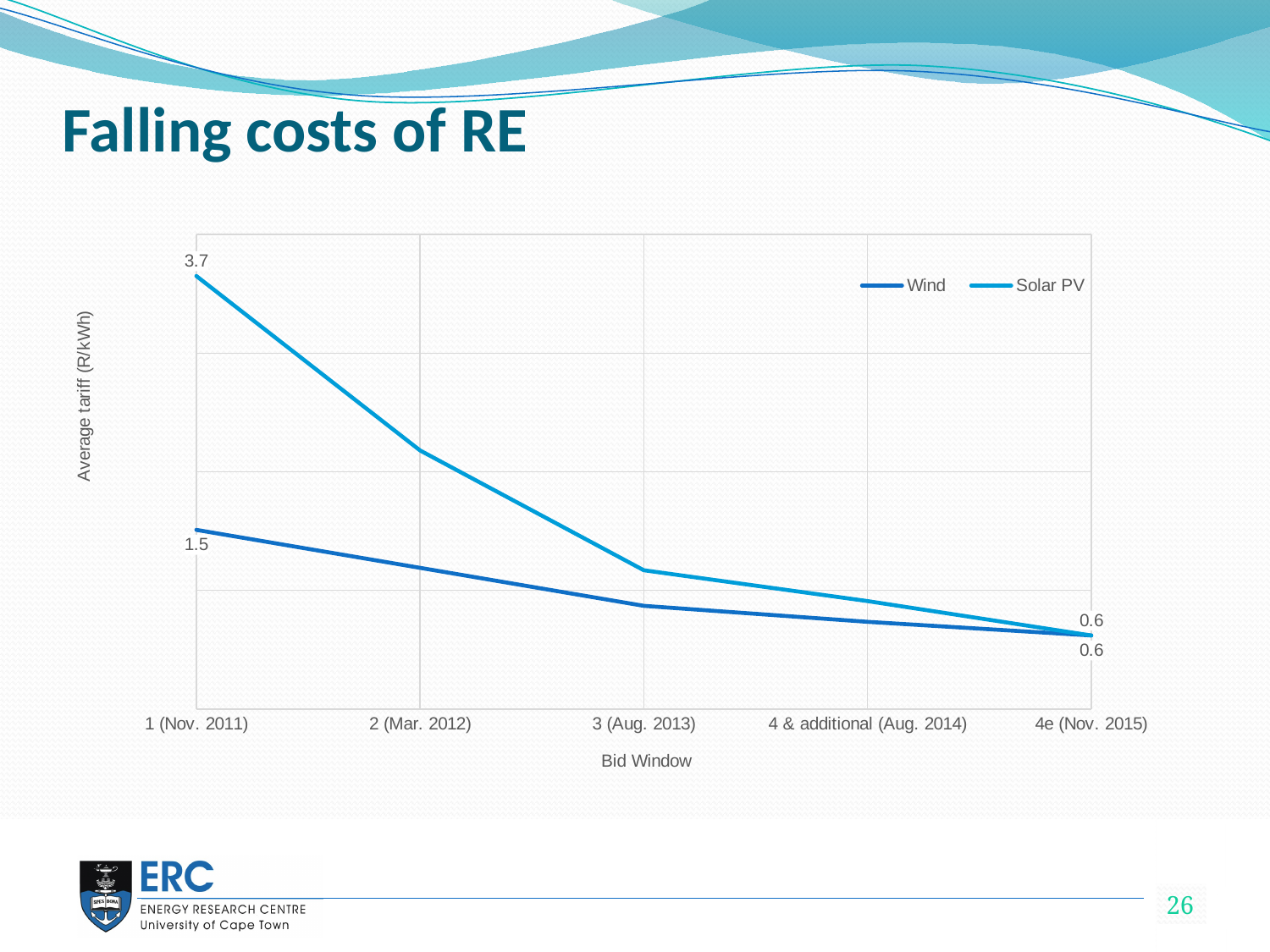
By how much did the Wind tariff fall from bid window 1 (Nov. 2011) to bid window 4e (Nov. 2015)? 0.9 What kind of chart is shown on the slide? Line chart At bid window 1 (Nov. 2011), how much higher is the Solar PV tariff than the Wind tariff? 2.2 At bid window 1 (Nov. 2011), which series has the higher average tariff, Wind or Solar PV? Solar PV What is the average tariff for Solar PV at bid window 1 (Nov. 2011)? 3.7 How many series does the legend list? 2 In which bid window is the Solar PV tariff highest? 1 (Nov. 2011) What is the average tariff for Solar PV at bid window 4e (Nov. 2015)? 0.6 How many bid windows are shown on the x axis? 5 By how much did the Solar PV tariff fall from bid window 1 (Nov. 2011) to bid window 4e (Nov. 2015)? 3.1 What is the average tariff for Wind at bid window 4e (Nov. 2015)? 0.6 What is the average tariff for Wind at bid window 1 (Nov. 2011)? 1.5